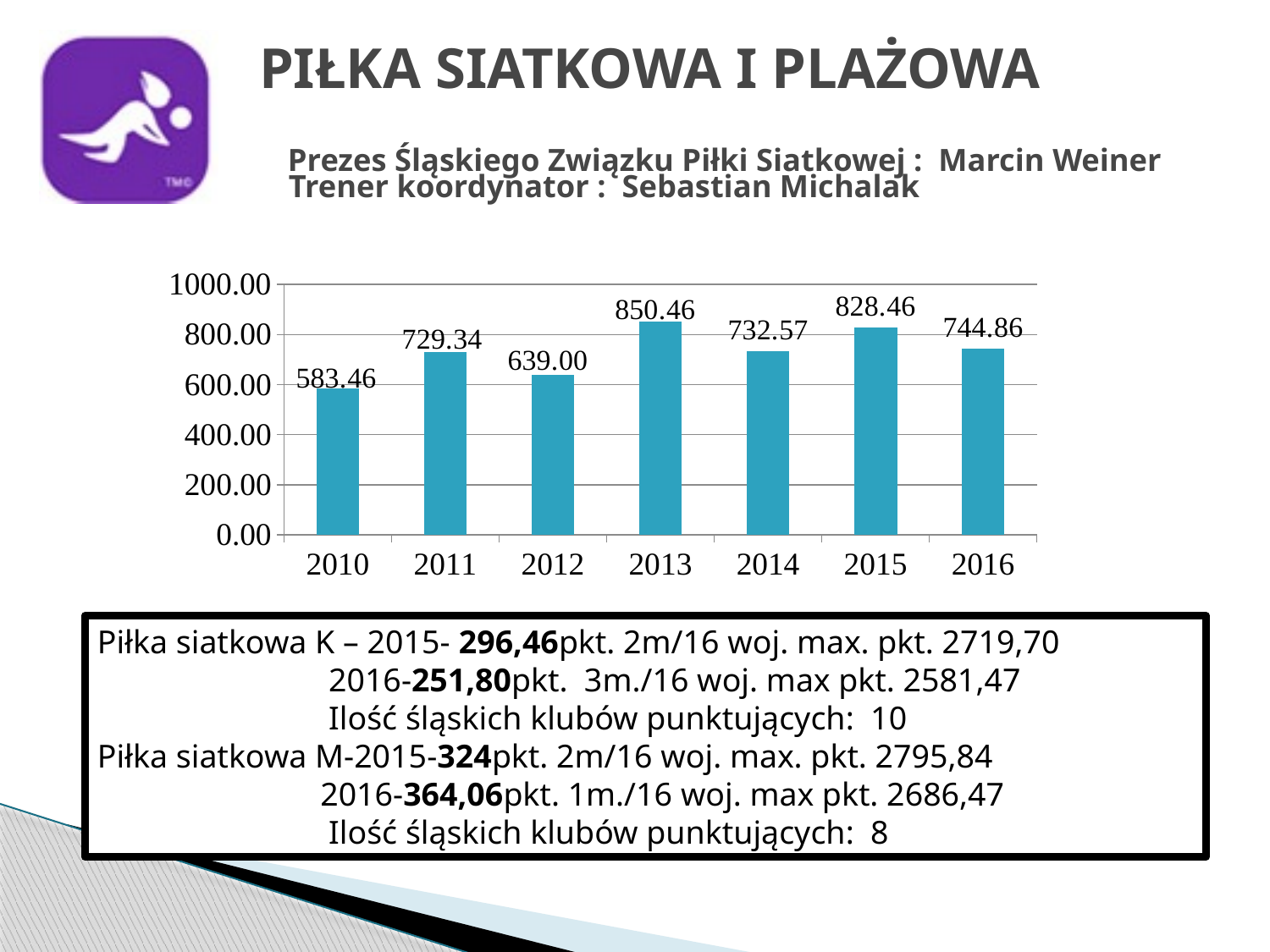
What is the value for 2013? 850.46 Does the value rise or fall from 2010 to 2011? rise What is the value for 2016? 744.86 What is the difference between the values for 2015 and 2016? 83.60 Which year has the highest value? 2013 What kind of chart is shown on the slide? bar chart What is the value for 2010? 583.46 Is the value for 2012 greater or less than 800.00? less How many years are shown on the x axis? 7 Which is larger, the value for 2012 or the value for 2015? 2015 Which year has the lowest value? 2010 What is the difference between the values for 2013 and 2010? 267.00